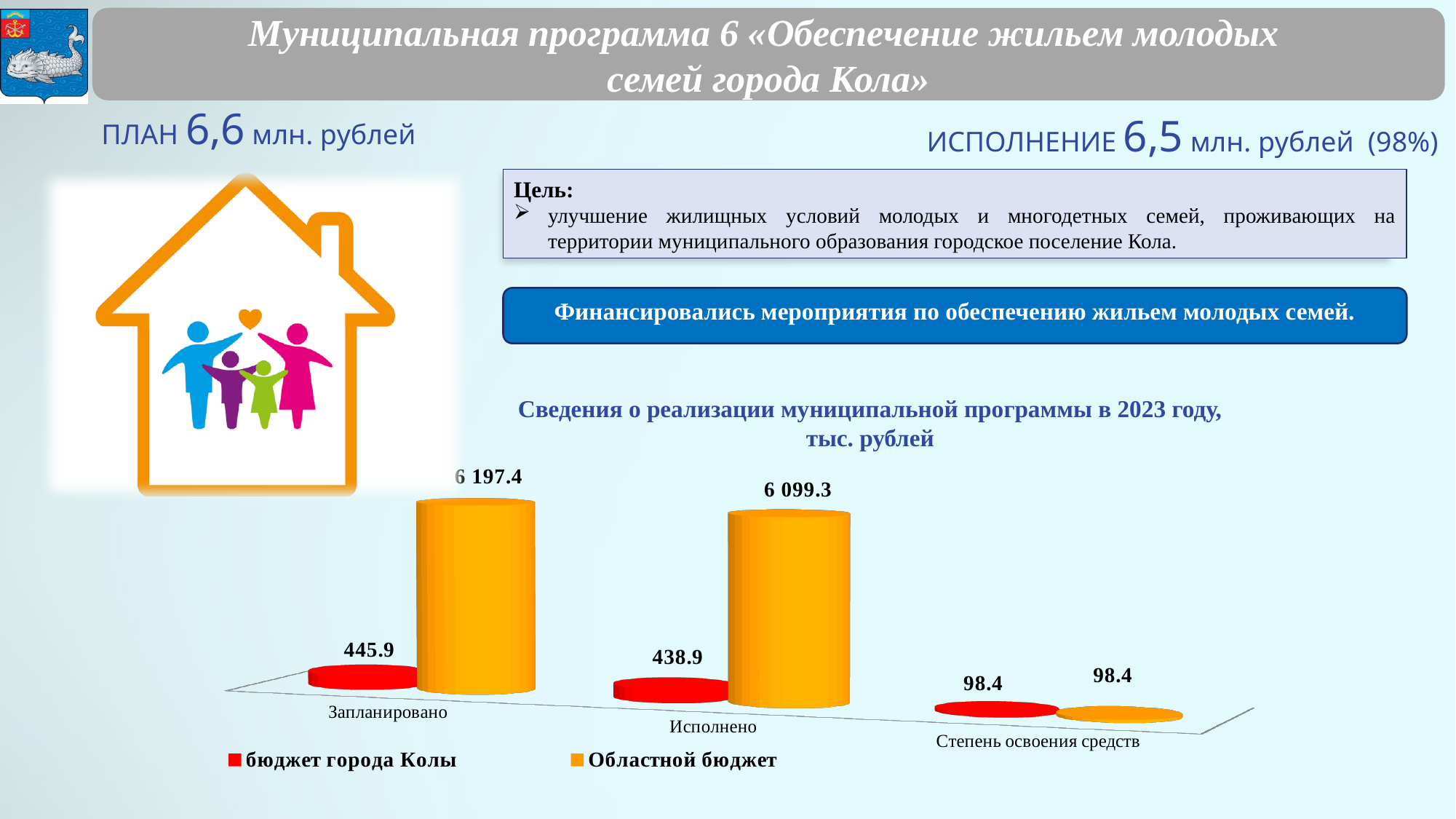
What is the value for «бюджет города Колы» in the «Запланировано» category? 445.9 How many categories are shown on the x axis of the chart? 3 What is the value for «Областной бюджет» in the «Степень освоения средств» category? 98.4 What is the value for «Областной бюджет» in the «Исполнено» category? 6 099.3 Which is larger: the «бюджет города Колы» value for «Запланировано» or for «Исполнено»? Запланировано In which category is the value for «Областной бюджет» highest? Запланировано What is the value for «Областной бюджет» in the «Запланировано» category? 6 197.4 What is the value for «бюджет города Колы» in the «Исполнено» category? 438.9 How many series does the chart legend list? 2 What type of chart is shown on the slide? Bar chart What is the difference between the «Областной бюджет» values for «Запланировано» and «Исполнено»? 98.1 In which category is the value for «бюджет города Колы» lowest? Степень освоения средств